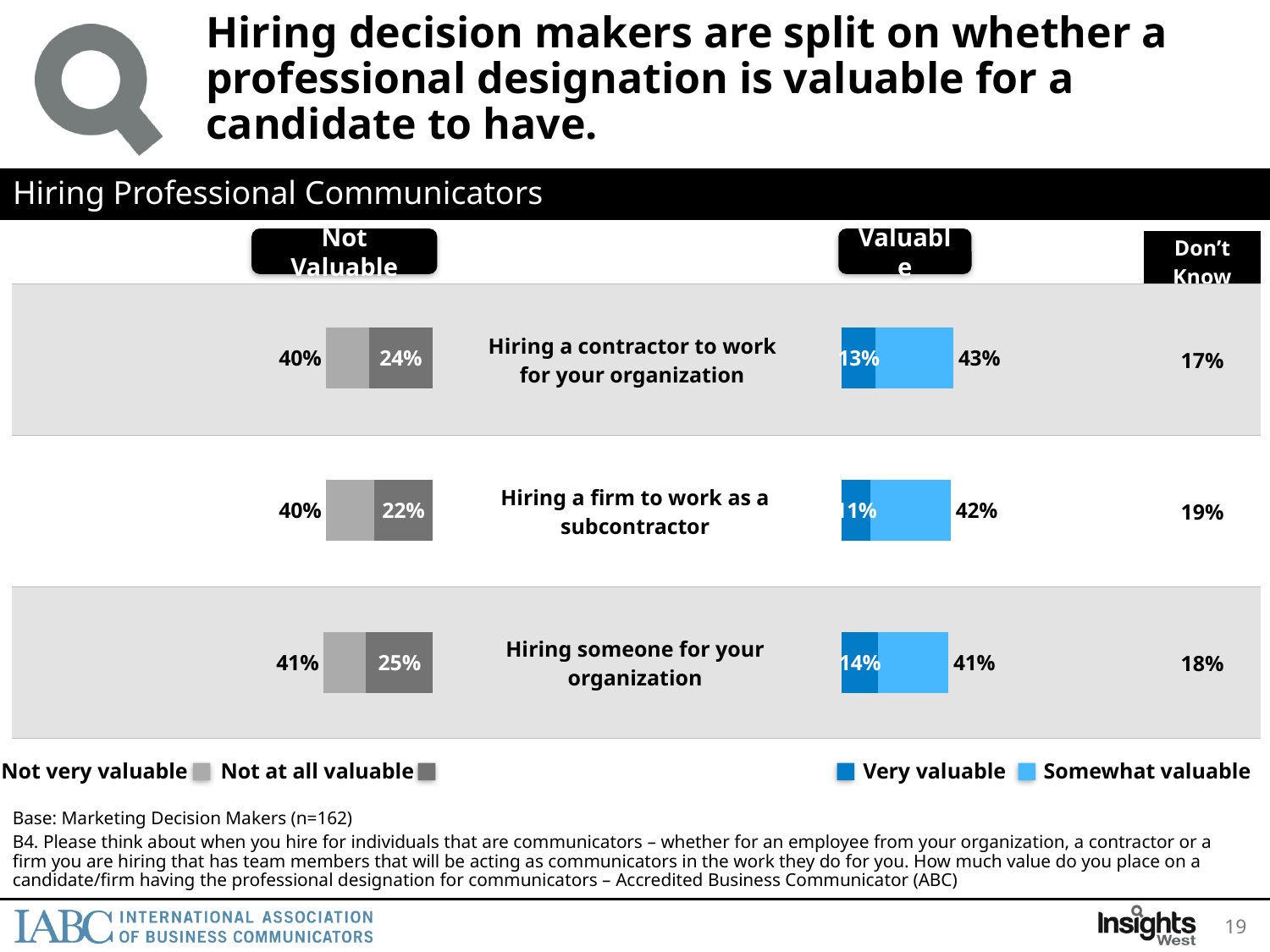
What type of chart is shown on the slide? Bar chart What is the 'Not at all valuable' percentage for hiring someone for your organization? 25% What is the 'Very valuable' percentage for hiring someone for your organization? 14% What is the 'Don't Know' percentage for hiring a firm to work as a subcontractor? 19% Which hiring scenario has the highest 'Not at all valuable' percentage? Hiring someone for your organization How many hiring scenarios are shown in the chart? 3 What is the combined 'Not Valuable' total (Not very valuable plus Not at all valuable) for hiring a firm to work as a subcontractor? 40% Which hiring scenario has the lowest 'Don't Know' percentage? Hiring a contractor to work for your organization What is the combined 'Valuable' total (Very valuable plus Somewhat valuable) for hiring a contractor to work for your organization? 43%